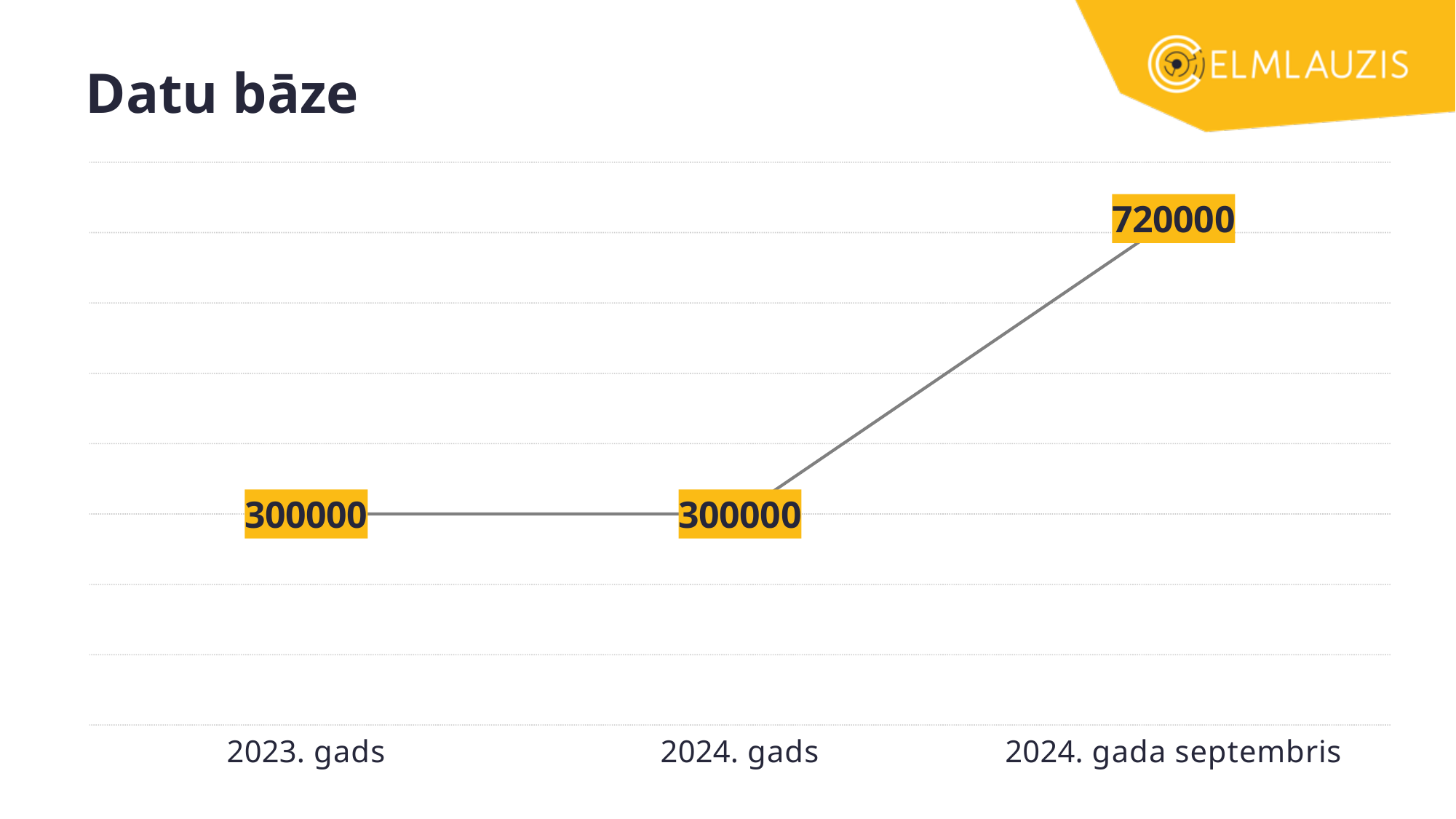
What is the value for 2024. gada septembris? 720000 What kind of chart is shown on the slide? Line chart Are the values for 2023. gads and 2024. gads equal? Yes What is the difference between the values for 2024. gada septembris and 2024. gads? 420000 What is the value for 2023. gads? 300000 Which is larger, the value for 2024. gada septembris or the value for 2023. gads? 2024. gada septembris Do the values change between 2023. gads and 2024. gads? No, they stay flat What is the value for 2024. gads? 300000 What is the title of the slide? Datu bāze Do the values rise, fall, or stay flat between 2024. gads and 2024. gada septembris? Rise Which category has the highest value? 2024. gada septembris How many data points are plotted on the chart? 3